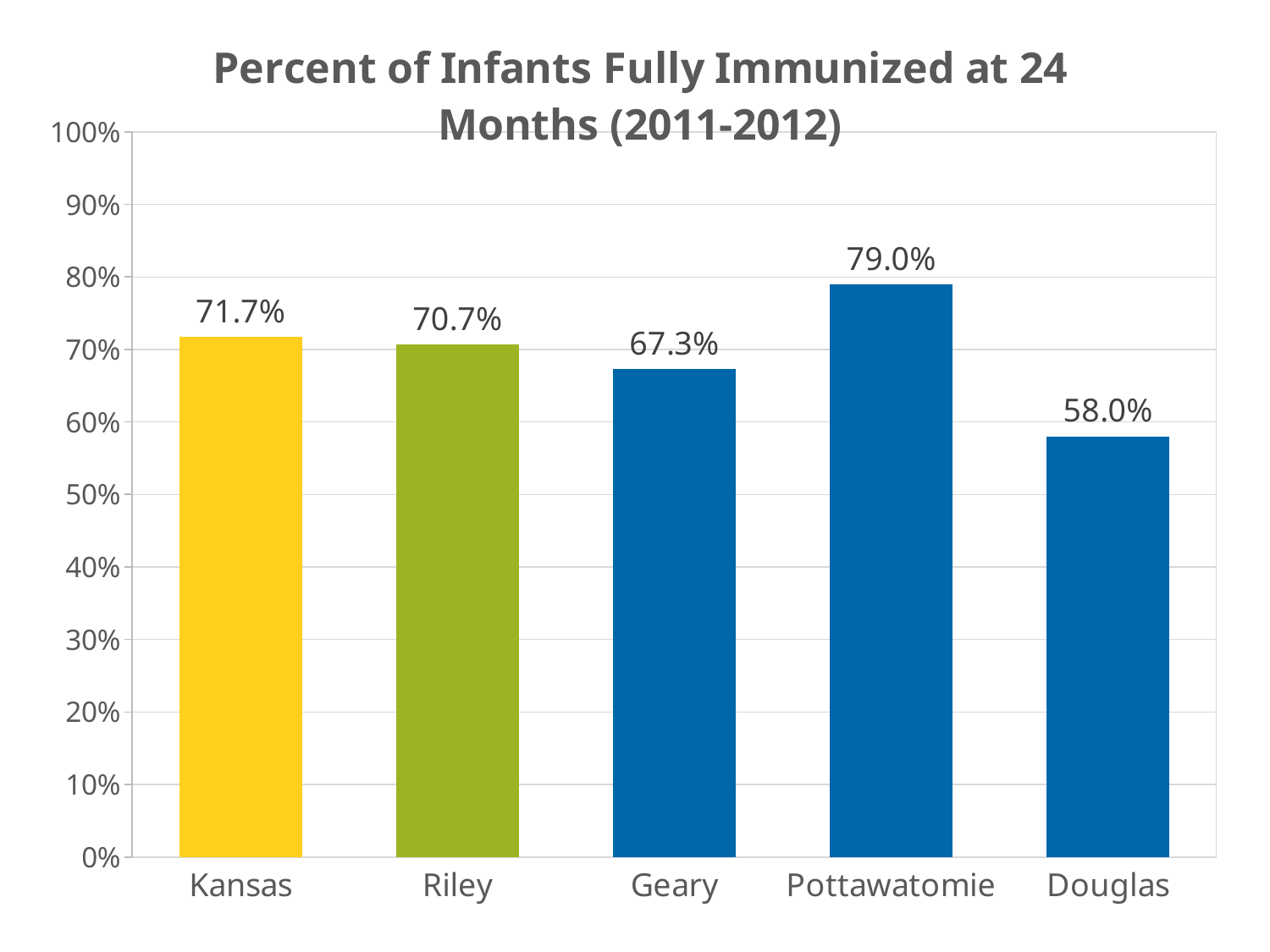
What is the title of the chart? Percent of Infants Fully Immunized at 24 Months (2011-2012) What is the difference between the values for Pottawatomie and Douglas? 21.0% Which category has the lowest value? Douglas How many categories are shown on the x axis? 5 What is the value for Pottawatomie? 79.0% What is the value for Douglas? 58.0% Which category has the highest value? Pottawatomie What is the value for Kansas? 71.7% Which is larger, the value for Geary or the value for Douglas? Geary What is the difference between the values for Kansas and Geary? 4.4% Is the value for Riley greater or less than 60%? greater What kind of chart is shown on the slide? bar chart